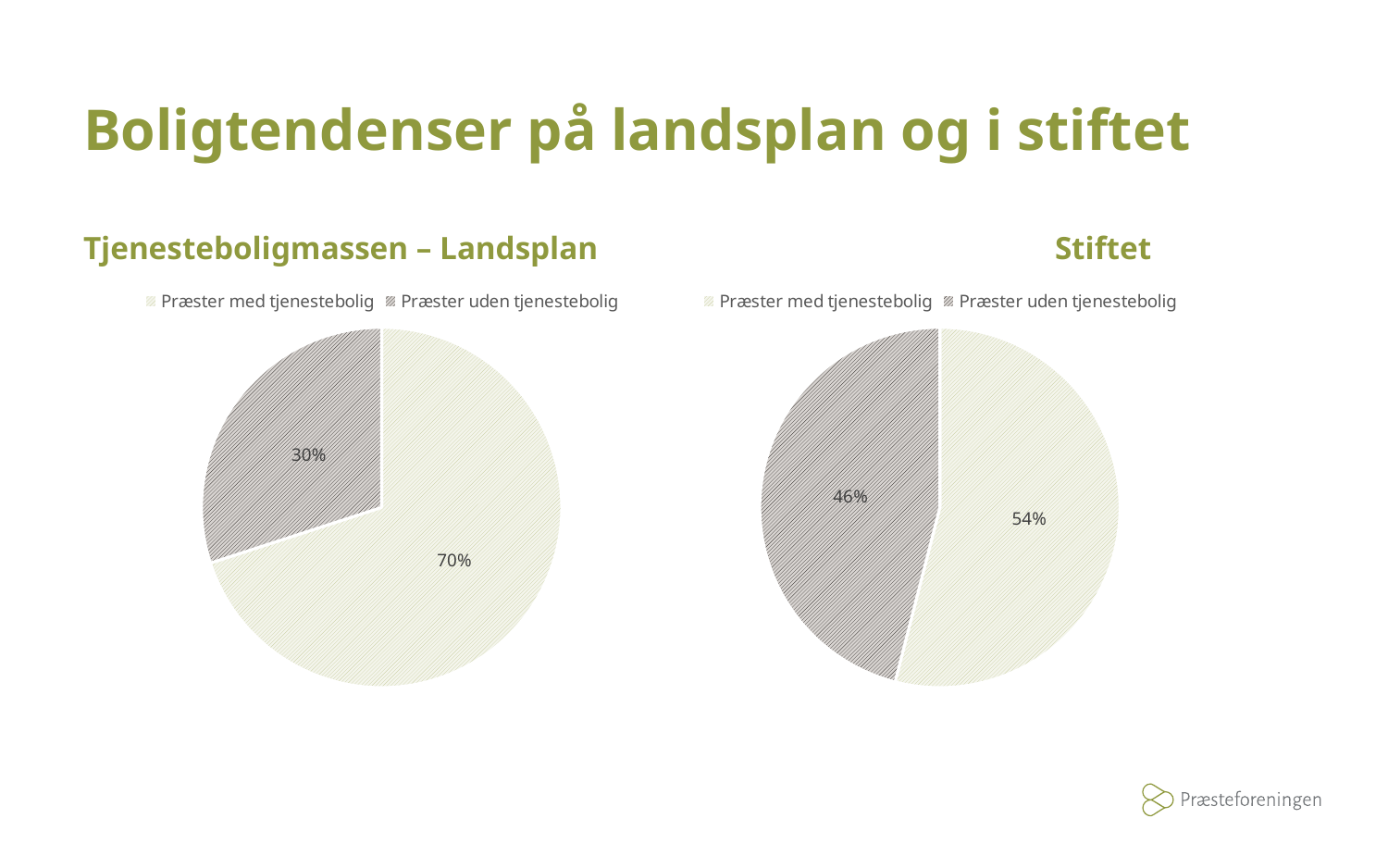
How many slices does the 'Tjenesteboligmassen – Landsplan' pie chart have? 2 How many entries does the legend of the 'Stiftet' chart list? 2 In the 'Tjenesteboligmassen – Landsplan' chart, what share is shown for Præster uden tjenestebolig? 30% In the 'Stiftet' chart, what share is shown for Præster med tjenestebolig? 54% Which chart shows a larger share for Præster uden tjenestebolig, 'Tjenesteboligmassen – Landsplan' or 'Stiftet'? Stiftet In the 'Stiftet' chart, what share is shown for Præster uden tjenestebolig? 46% In the 'Stiftet' chart, what is the difference in percentage points between Præster med tjenestebolig and Præster uden tjenestebolig? 8 percentage points In the 'Tjenesteboligmassen – Landsplan' chart, what is the difference in percentage points between Præster med tjenestebolig and Præster uden tjenestebolig? 40 percentage points In the 'Tjenesteboligmassen – Landsplan' chart, what share is shown for Præster med tjenestebolig? 70% In the 'Stiftet' chart, which category has the smallest slice? Præster uden tjenestebolig In the 'Tjenesteboligmassen – Landsplan' chart, which category has the largest slice? Præster med tjenestebolig What type of chart is the 'Stiftet' chart? Pie chart